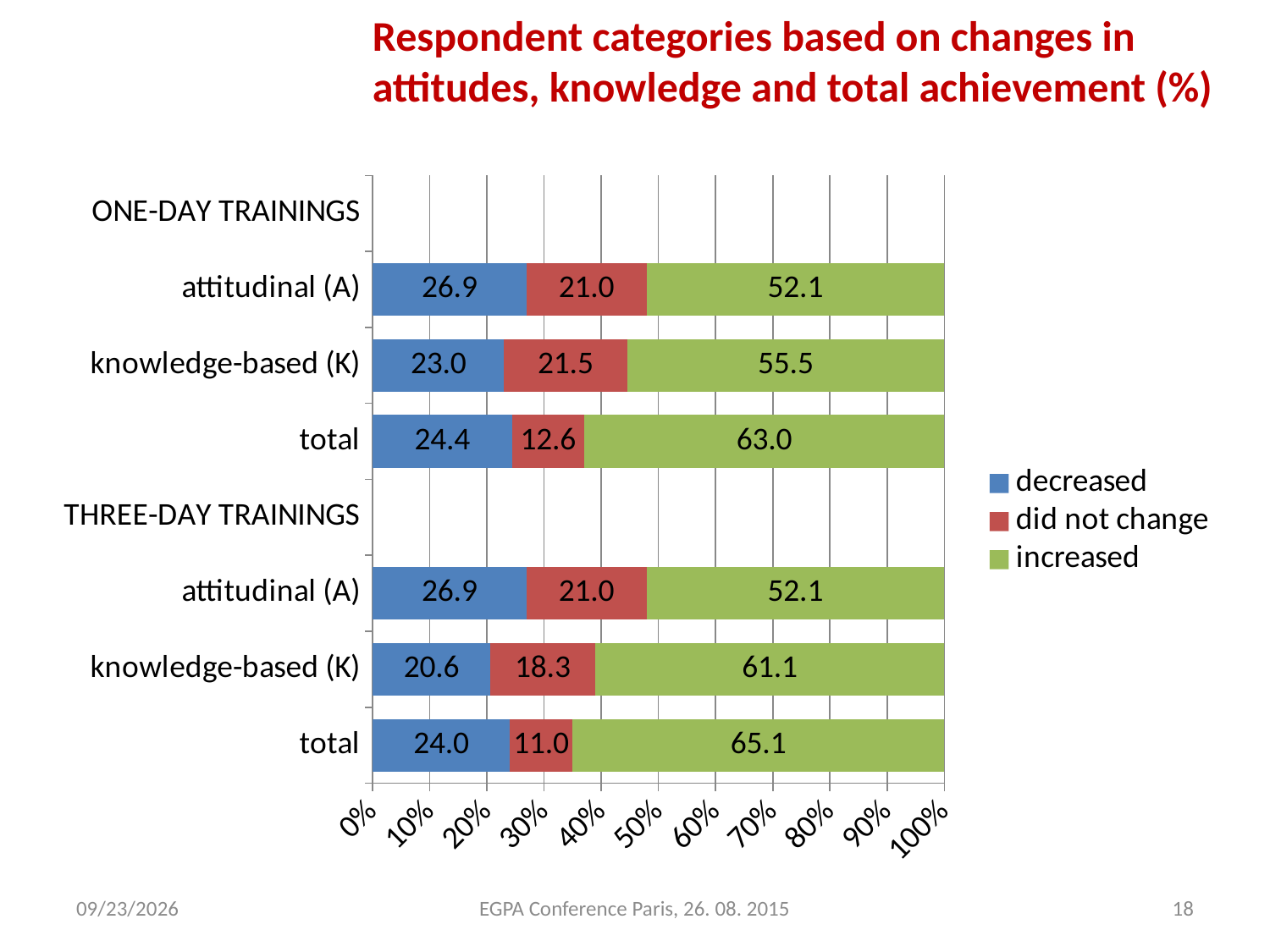
What is the 'increased' value for total under THREE-DAY TRAININGS? 65.1 How many series does the legend list? 3 Which is larger: the 'decreased' value for knowledge-based (K) under ONE-DAY TRAININGS or under THREE-DAY TRAININGS? ONE-DAY TRAININGS (23.0) Which bar has the highest 'increased' value? total (THREE-DAY TRAININGS) What is the 'did not change' value for knowledge-based (K) under ONE-DAY TRAININGS? 21.5 Is the 'increased' value for attitudinal (A) under ONE-DAY TRAININGS greater or less than 50%? greater What are the three series named in the legend? decreased, did not change, increased What is the difference between the 'increased' values for total under THREE-DAY TRAININGS and total under ONE-DAY TRAININGS? 2.1 What kind of chart is shown on the slide? stacked bar chart What is the 'did not change' value for total under ONE-DAY TRAININGS? 12.6 What is the 'decreased' value for knowledge-based (K) under THREE-DAY TRAININGS? 20.6 Which bar has the lowest 'did not change' value? total (THREE-DAY TRAININGS)